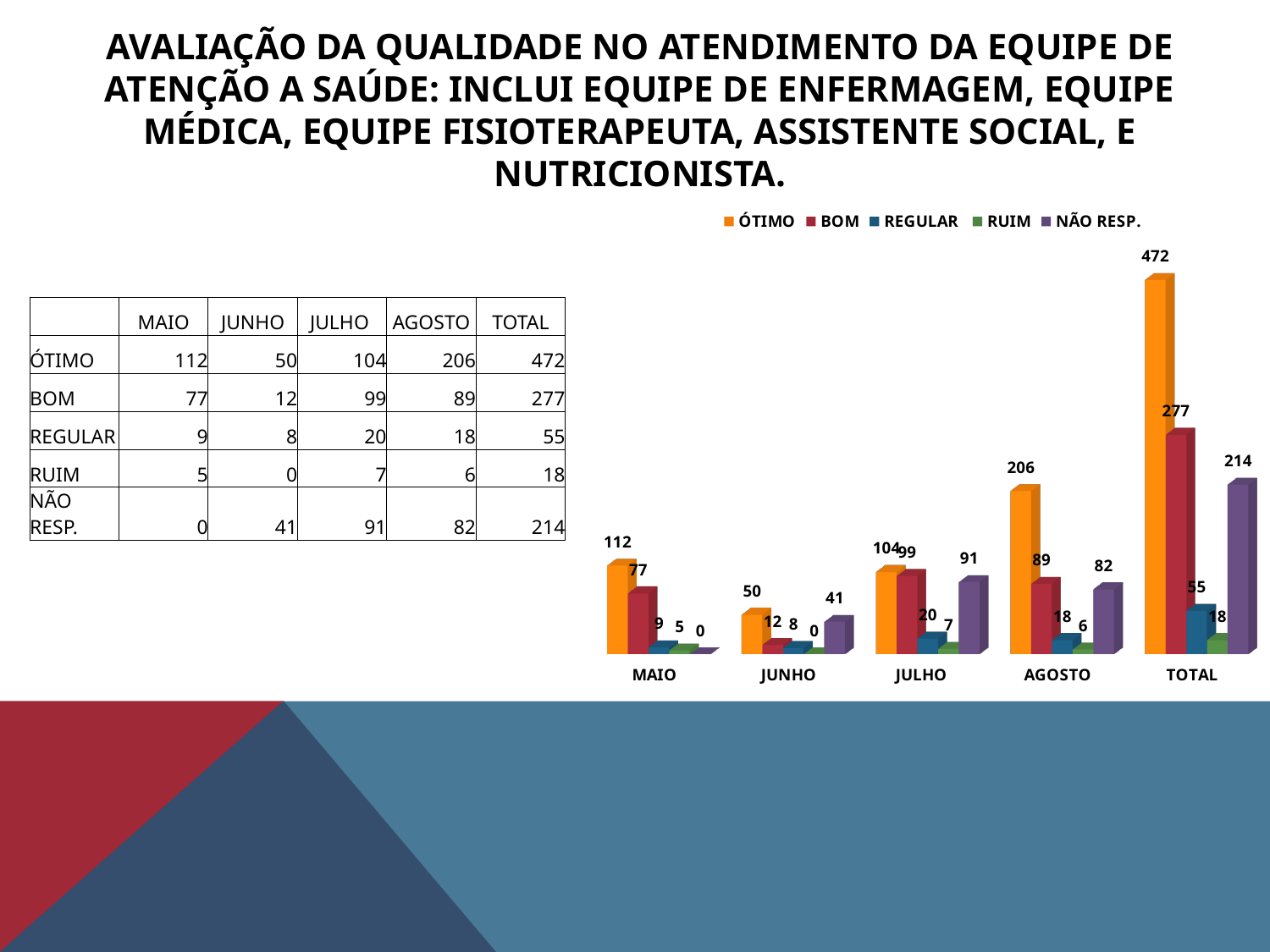
Which month has the highest ÓTIMO value (excluding TOTAL)? AGOSTO Which is larger in JULHO, ÓTIMO or BOM? ÓTIMO How many series does the legend list? 5 What is the value for ÓTIMO in AGOSTO? 206 Does the REGULAR value rise or fall from MAIO to JULHO? Rise Which month has the lowest BOM value? JUNHO What kind of chart is shown? Bar chart How many categories are shown on the x axis? 5 What is the value for BOM in JUNHO? 12 What is the difference between the ÓTIMO and BOM values in the TOTAL group? 195 What is the value for NÃO RESP. in JULHO? 91 Which series is shown in orange in the legend? ÓTIMO